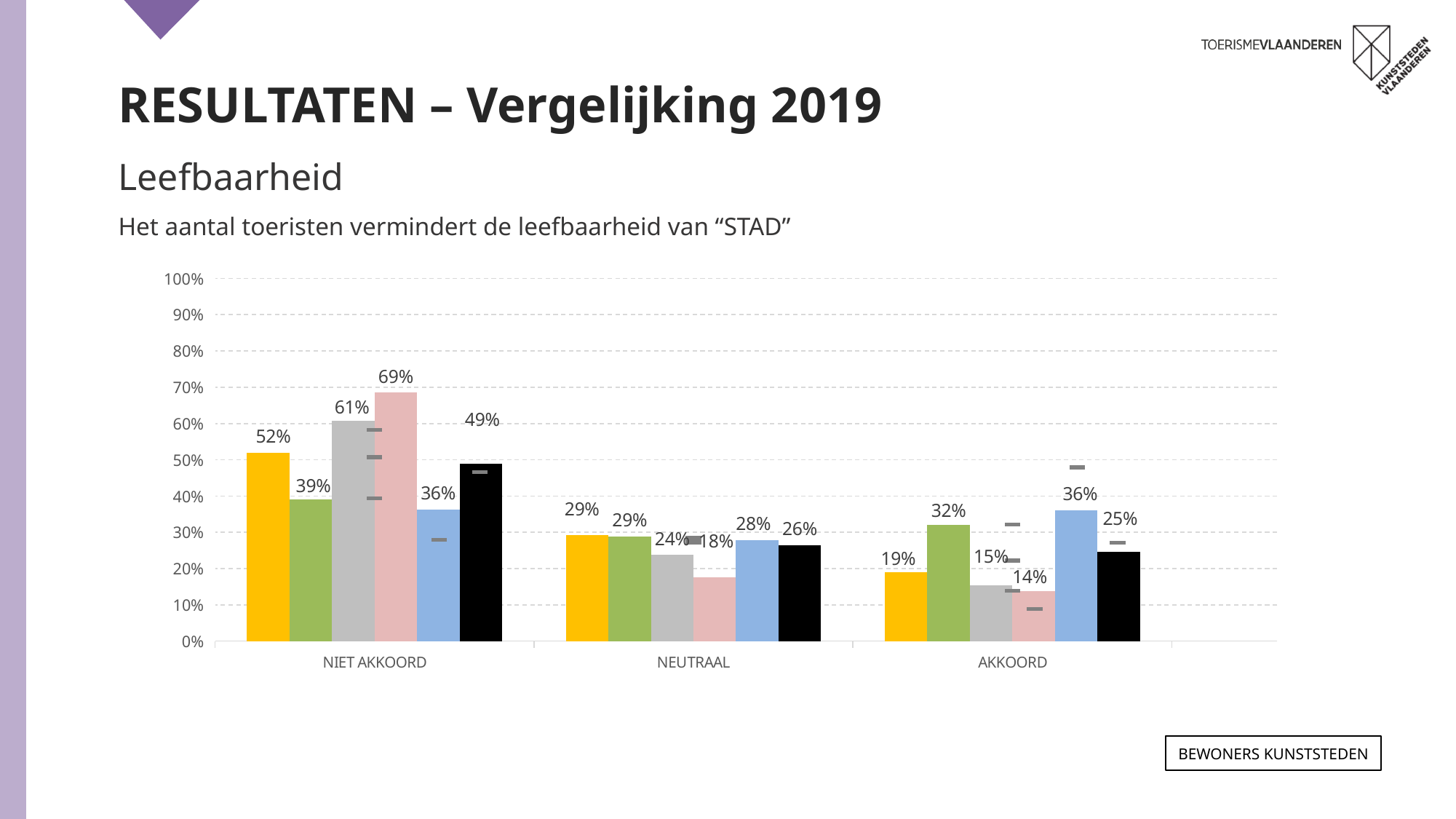
How many categories are shown on the x axis of the chart? 3 Which bar is the lowest in the AKKOORD category? the pink bar (14%) What is the value of the blue bar in the AKKOORD category? 36% In the AKKOORD category, which is larger: the green bar or the yellow bar? the green bar (32%) How many bars are shown in each category of the chart? 6 What is the value of the black bar in the NEUTRAAL category? 26% What is the subtitle statement shown above the chart? Het aantal toeristen vermindert de leefbaarheid van "STAD" What type of chart is shown on the slide? bar chart What is the value of the pink bar in the NIET AKKOORD category? 69% What is the difference between the grey bar and the green bar in the NIET AKKOORD category? 22 percentage points Which bar is the highest in the NIET AKKOORD category? the pink bar (69%) What is the value of the yellow bar in the NIET AKKOORD category? 52%